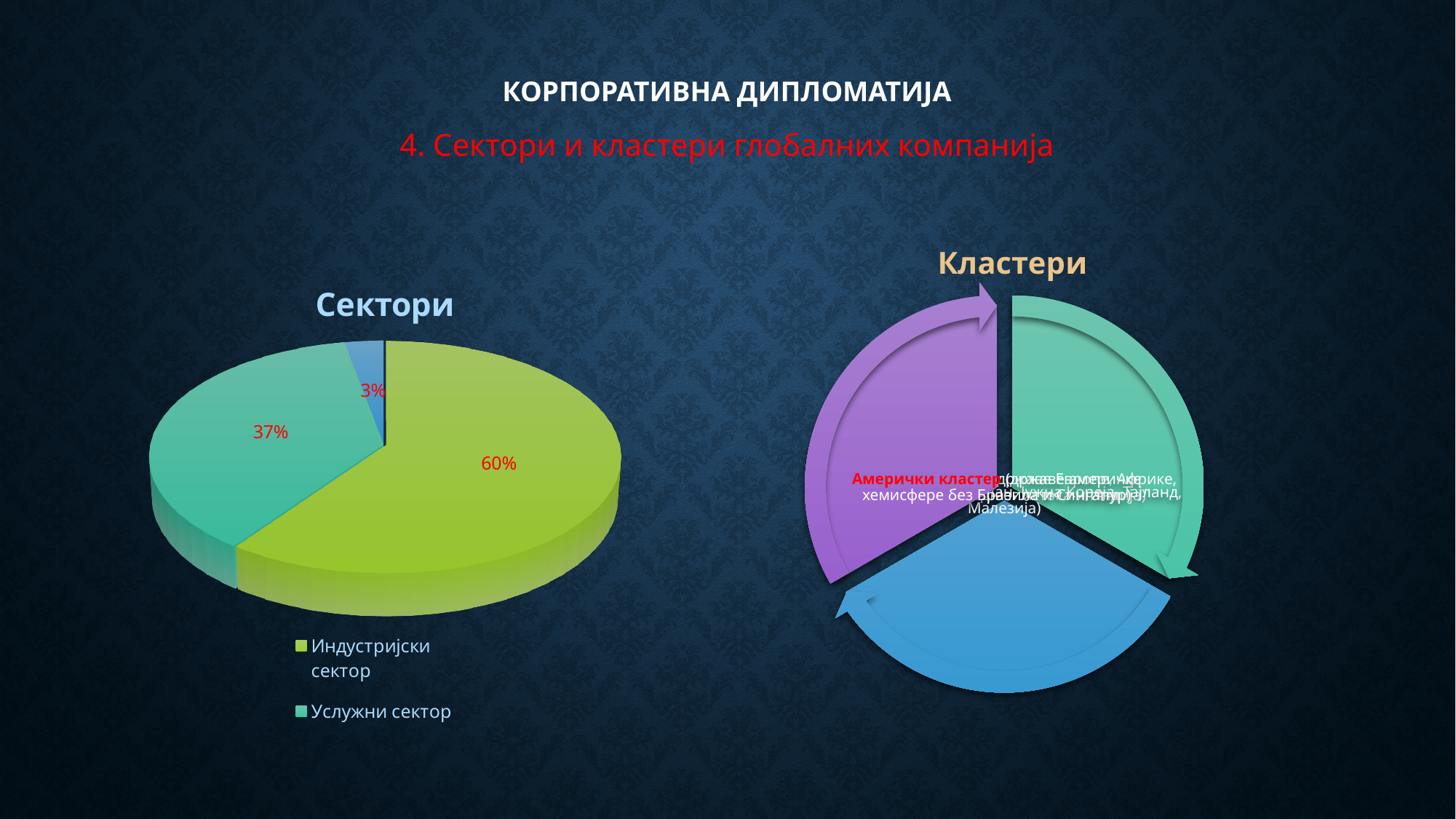
In the pie chart titled Сектори, what is the difference in percentage points between Индустријски сектор and Услужни сектор? 23 percentage points In the pie chart titled Сектори, what percentage is shown for Индустријски сектор? 60% How many slices does the pie chart titled Сектори have? 3 In the pie chart titled Сектори, which is larger: Индустријски сектор or Услужни сектор? Индустријски сектор In the pie chart titled Сектори, what is the value of the smallest slice? 3% What is the title of the chart on the left side of the slide? Сектори In the pie chart titled Сектори, is the value for Услужни сектор greater or less than 50%? less In the pie chart titled Сектори, what percentage is shown for Услужни сектор? 37% How many entries does the legend of the pie chart titled Сектори list? 2 What kind of chart is the chart titled Сектори on the left of the slide? Pie chart In the pie chart titled Сектори, what combined share do Индустријски сектор and Услужни сектор make up together? 97% In the pie chart titled Сектори, which legend category has the largest slice? Индустријски сектор